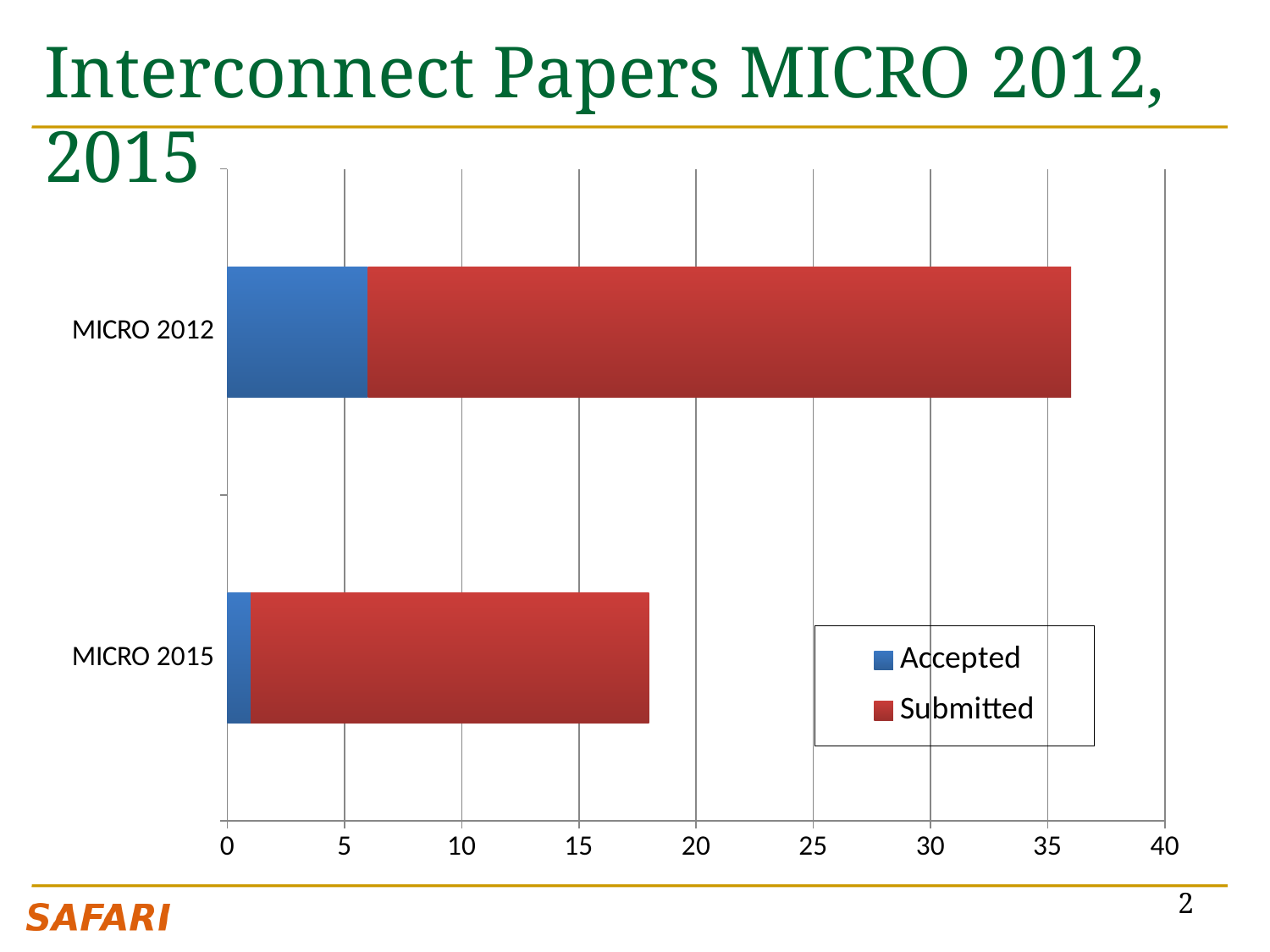
Is the total bar length for MICRO 2015 greater or less than 15? greater Is the total bar length for MICRO 2015 greater or less than 20? less Is the Accepted segment for MICRO 2012 greater or less than 10? less Which category has the shorter total bar? MICRO 2015 Which category has the larger Accepted segment, MICRO 2012 or MICRO 2015? MICRO 2012 How many categories are plotted on the chart? 2 How many series does the legend list? 2 Which colour represents the Submitted series in the legend? red Which category has the longer total bar, MICRO 2012 or MICRO 2015? MICRO 2012 What kind of chart is shown on the slide? bar chart